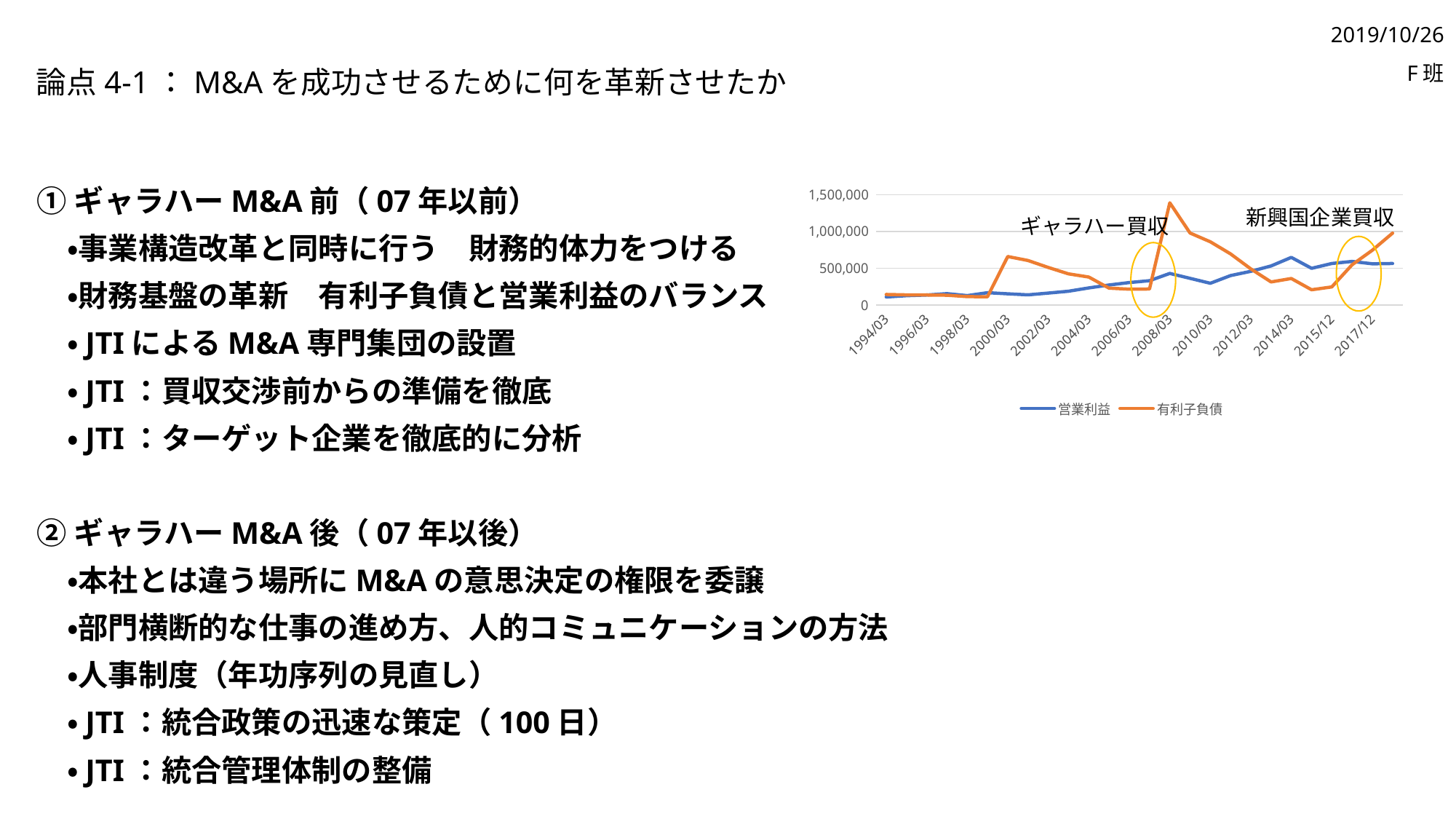
What kind of chart is shown on the slide? line chart Overall, does the 営業利益 line rise or fall from 1994/03 to 2017/12? rise At 2014/03, which series has the larger value, 営業利益 or 有利子負債? 営業利益 Is the value of 有利子負債 at 2017/12 greater or less than 500,000? greater Is the value of 有利子負債 at 2000/03 greater or less than 500,000? greater Is the value of 有利子負債 at 2008/03 greater or less than 1,000,000? greater At which x-axis date does the 有利子負債 line reach its highest point? 2008/03 How many series does the chart's legend list? 2 At 2000/03, which series has the larger value, 営業利益 or 有利子負債? 有利子負債 Which colour is used for the 有利子負債 line? orange What are the two series named in the chart's legend? 営業利益 and 有利子負債